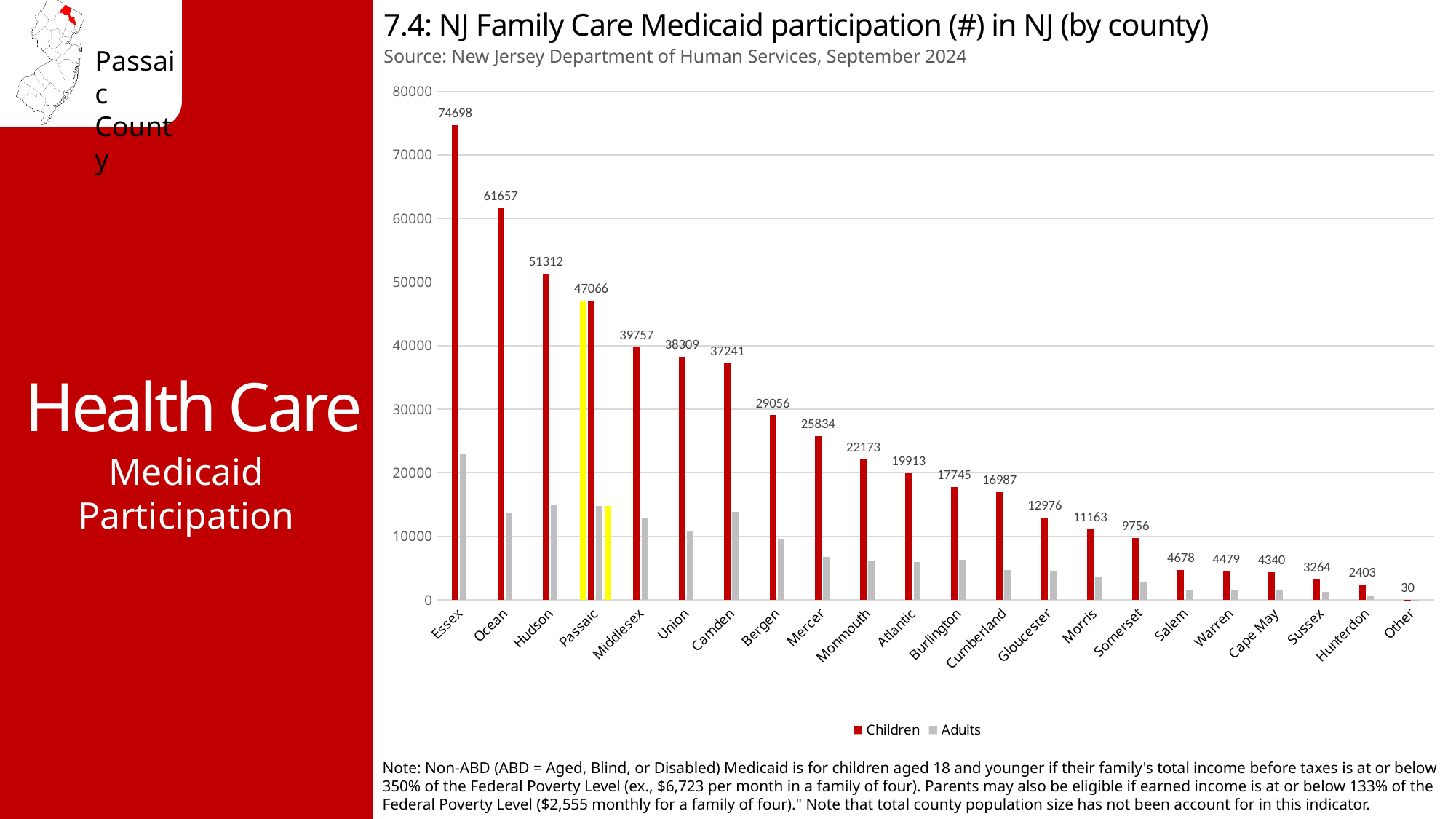
What kind of chart is shown on the slide? bar chart What is the Children value for Passaic? 47066 How many categories are shown on the x axis? 22 Is the Adults value for Passaic greater or less than 20000? less Which has a larger Children value, Bergen or Mercer? Bergen Which county has the highest Children value? Essex How many series does the legend list? 2 What is the Children value for Hudson? 51312 What is the difference between the Children values for Essex and Ocean? 13041 What is the Children value for Somerset? 9756 Is the Adults value for Essex greater or less than 20000? greater Which category has the lowest Children value? Other